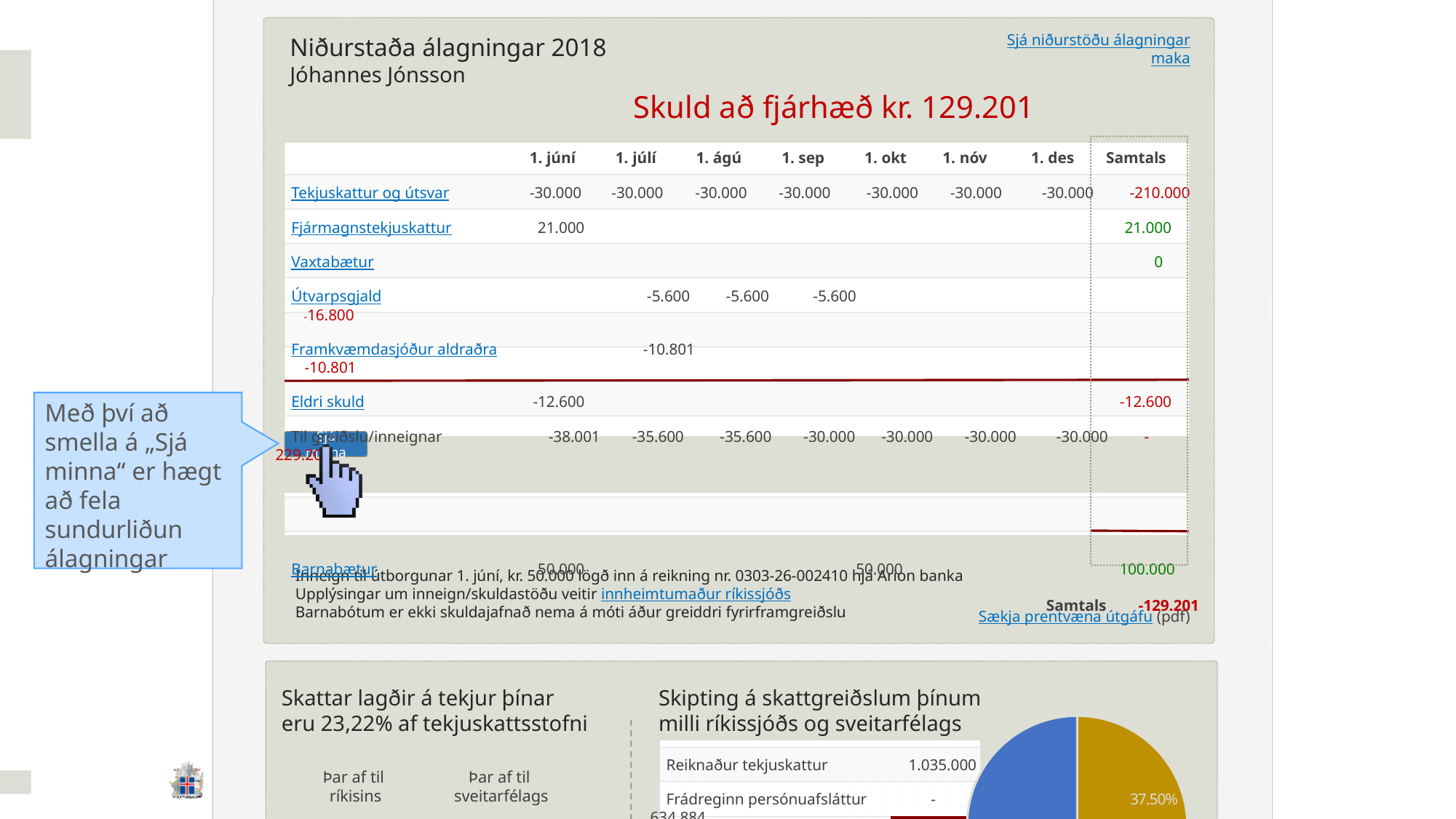
What colours are the two slices of the pie chart? blue and gold What kind of chart is shown at the bottom right of the slide? pie chart In the pie chart, which slice is larger, the blue one or the gold one? the blue one In the pie chart, what percentage is printed on the gold slice? 37.50% What is the title of the pie chart at the bottom right of the slide? Skipting á skattgreiðslum þínum milli ríkissjóðs og sveitarfélags How many slices does the pie chart show? 2 Is the share of the gold slice in the pie chart greater or less than 50%? less